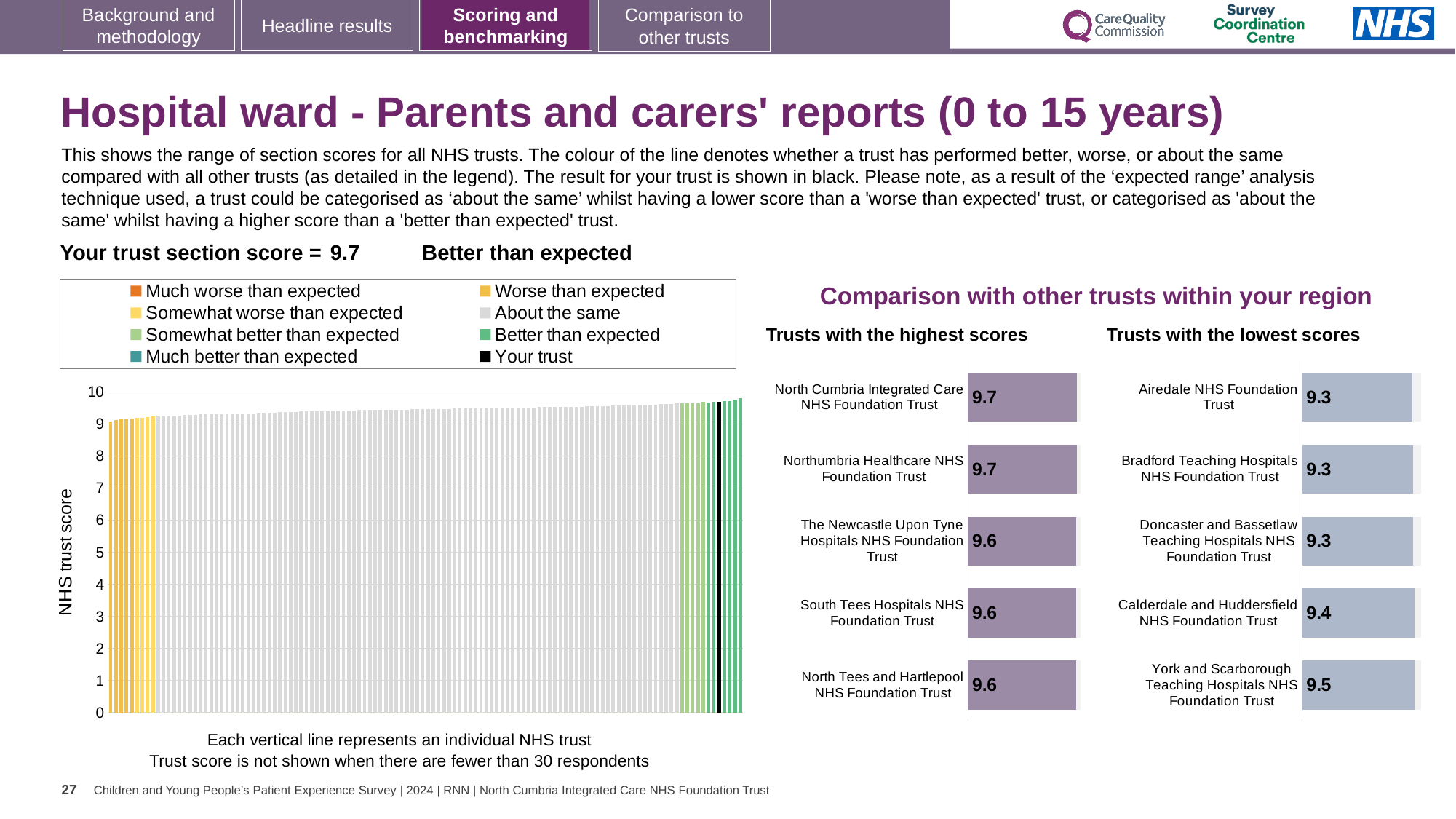
In the 'Trusts with the lowest scores' chart, which has the larger score: Calderdale and Huddersfield NHS Foundation Trust or Bradford Teaching Hospitals NHS Foundation Trust? Calderdale and Huddersfield NHS Foundation Trust In the 'Trusts with the lowest scores' chart, what is the difference between the scores of York and Scarborough Teaching Hospitals NHS Foundation Trust and Airedale NHS Foundation Trust? 0.2 How many trusts are shown in the 'Trusts with the highest scores' chart? 5 In the 'Trusts with the highest scores' chart, what is the score for South Tees Hospitals NHS Foundation Trust? 9.6 In the 'Trusts with the lowest scores' chart, what is the score for Airedale NHS Foundation Trust? 9.3 In the 'Trusts with the lowest scores' chart, which trust has the highest score? York and Scarborough Teaching Hospitals NHS Foundation Trust In the main chart on the left, are the values for the yellow (worse than expected) trusts greater or less than 8? greater How many entries does the legend of the main chart on the left list? 8 What is the y-axis label of the main chart on the left? NHS trust score In the 'Trusts with the lowest scores' chart, what is the score for Calderdale and Huddersfield NHS Foundation Trust? 9.4 In the 'Trusts with the highest scores' chart, what is the score for North Cumbria Integrated Care NHS Foundation Trust? 9.7 What kind of chart is the 'Trusts with the lowest scores' chart? Bar chart